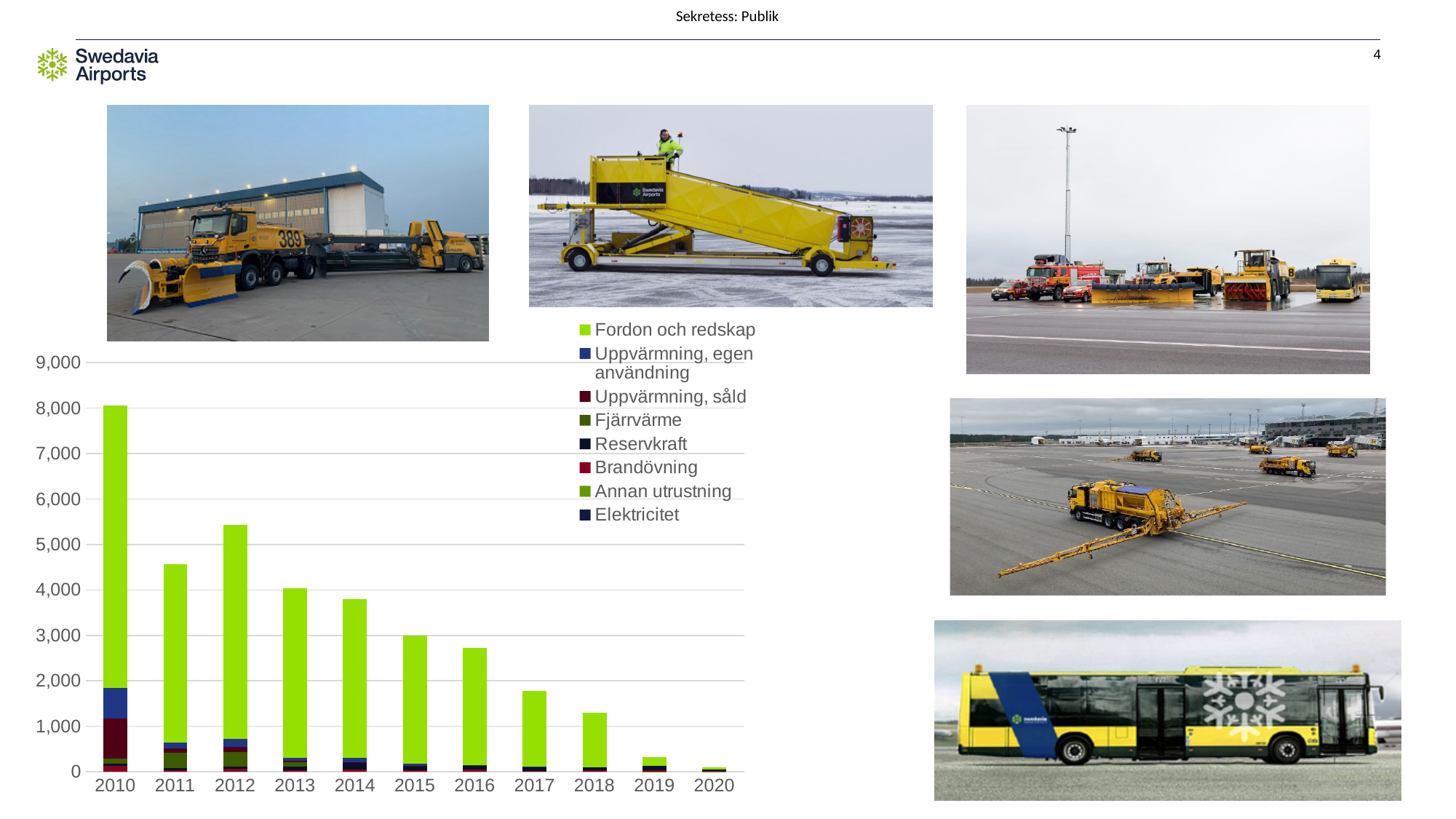
Which year has the larger total bar, 2011 or 2012? 2012 What kind of chart is shown on the slide? Stacked bar chart Is the total value for 2014 greater or less than 4,000? less Is the total value for 2010 greater or less than 7,000? greater Which year has the lowest total bar in the chart? 2020 Do the total bar values generally rise or fall from 2010 to 2020? Fall Which legend entry is shown in bright green and makes up most of each bar? Fordon och redskap Is the total value for 2018 greater or less than 1,000? greater Which year has the highest total bar in the chart? 2010 How many series does the chart's legend list? 8 How many years are shown on the x axis of the chart? 11